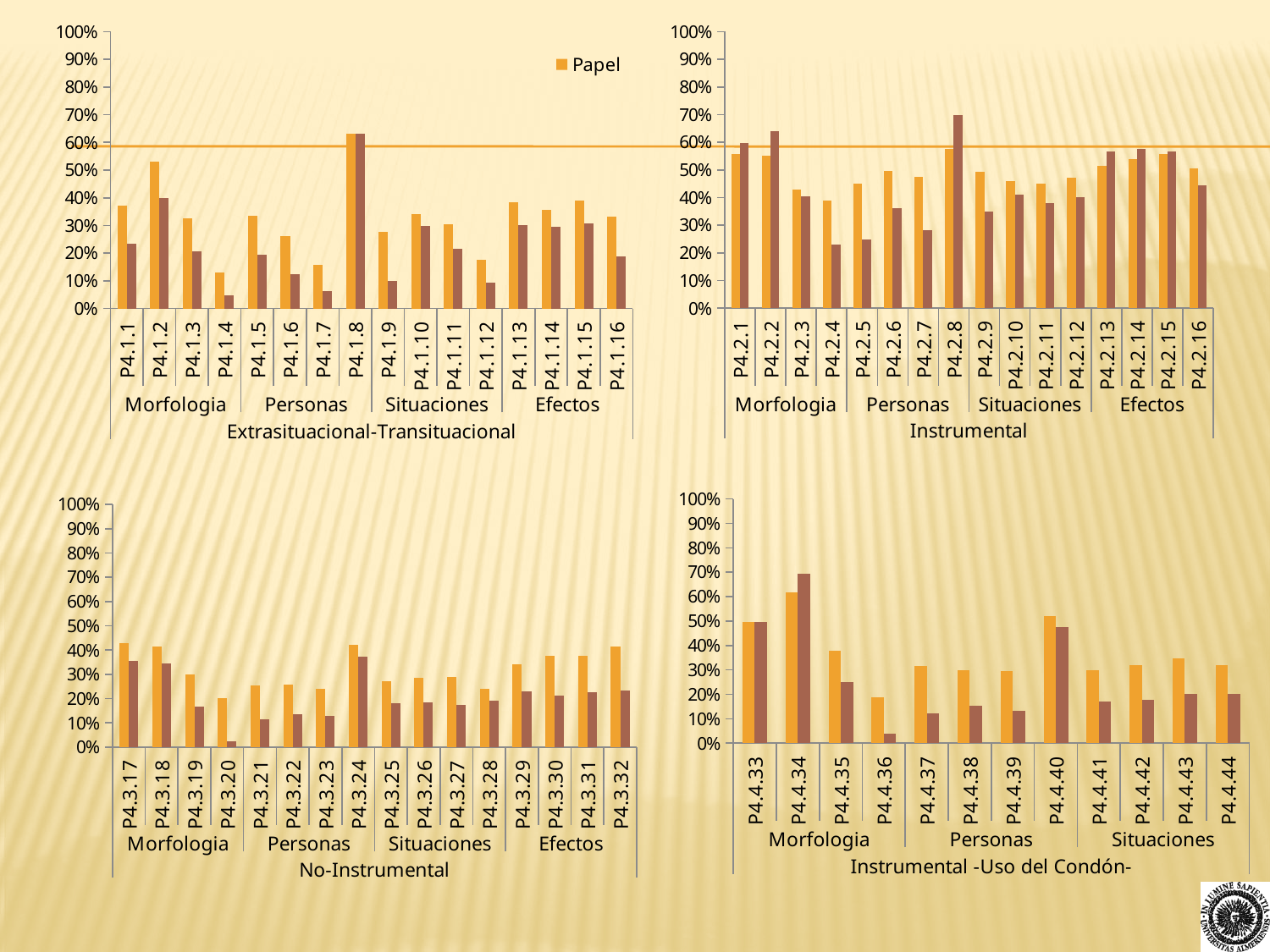
In the 'Instrumental -Uso del Condón-' chart, which category has the highest brown bar? P4.4.34 In the 'Instrumental -Uso del Condón-' chart, is the brown bar for P4.4.36 greater or less than 10%? less What series name is shown in the legend of the 'Extrasituacional-Transituacional' chart? Papel In the 'No-Instrumental' chart, which category has the lowest brown bar? P4.3.20 In the 'Instrumental' chart, which category has the highest brown bar? P4.2.8 What kind of chart is the 'Extrasituacional-Transituacional' chart? bar chart In the 'Extrasituacional-Transituacional' chart, how many categories are shown on the x axis? 16 In the 'Extrasituacional-Transituacional' chart, which is larger, the orange bar for P4.1.2 or the orange bar for P4.1.4? P4.1.2 In the 'Instrumental' chart, is the brown bar for P4.2.8 greater or less than 60%? greater In the 'Extrasituacional-Transituacional' chart, which category has the lowest orange bar? P4.1.4 In the 'Instrumental -Uso del Condón-' chart, how many categories are shown on the x axis? 12 In the 'Extrasituacional-Transituacional' chart, which category has the highest orange bar? P4.1.8